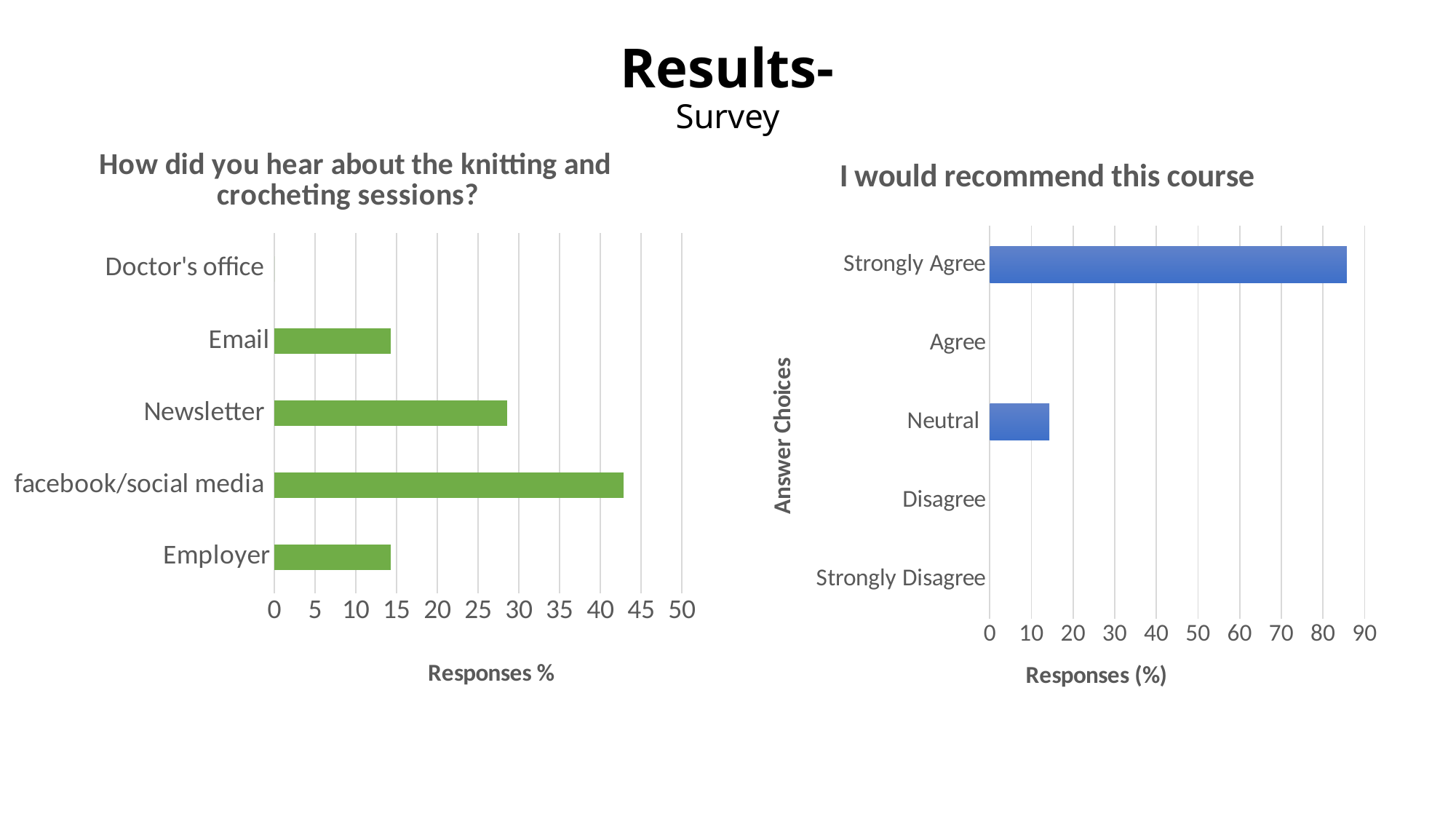
In the 'How did you hear about the knitting and crocheting sessions?' chart, is the value for facebook/social media greater or less than 40? greater In the 'How did you hear about the knitting and crocheting sessions?' chart, which is larger, Newsletter or Employer? Newsletter In the 'How did you hear about the knitting and crocheting sessions?' chart, which category has the highest value? facebook/social media In the 'How did you hear about the knitting and crocheting sessions?' chart, which category has the lowest value? Doctor's office How many categories are shown in the 'How did you hear about the knitting and crocheting sessions?' chart? 5 In the 'I would recommend this course' chart, is the value for Neutral greater or less than 20? less In the 'How did you hear about the knitting and crocheting sessions?' chart, is the value for Newsletter greater or less than 25? greater What kind of chart is the 'How did you hear about the knitting and crocheting sessions?' chart? bar chart What is the x-axis label of the 'I would recommend this course' chart? Responses (%) In the 'I would recommend this course' chart, which answer choice has the highest value? Strongly Agree